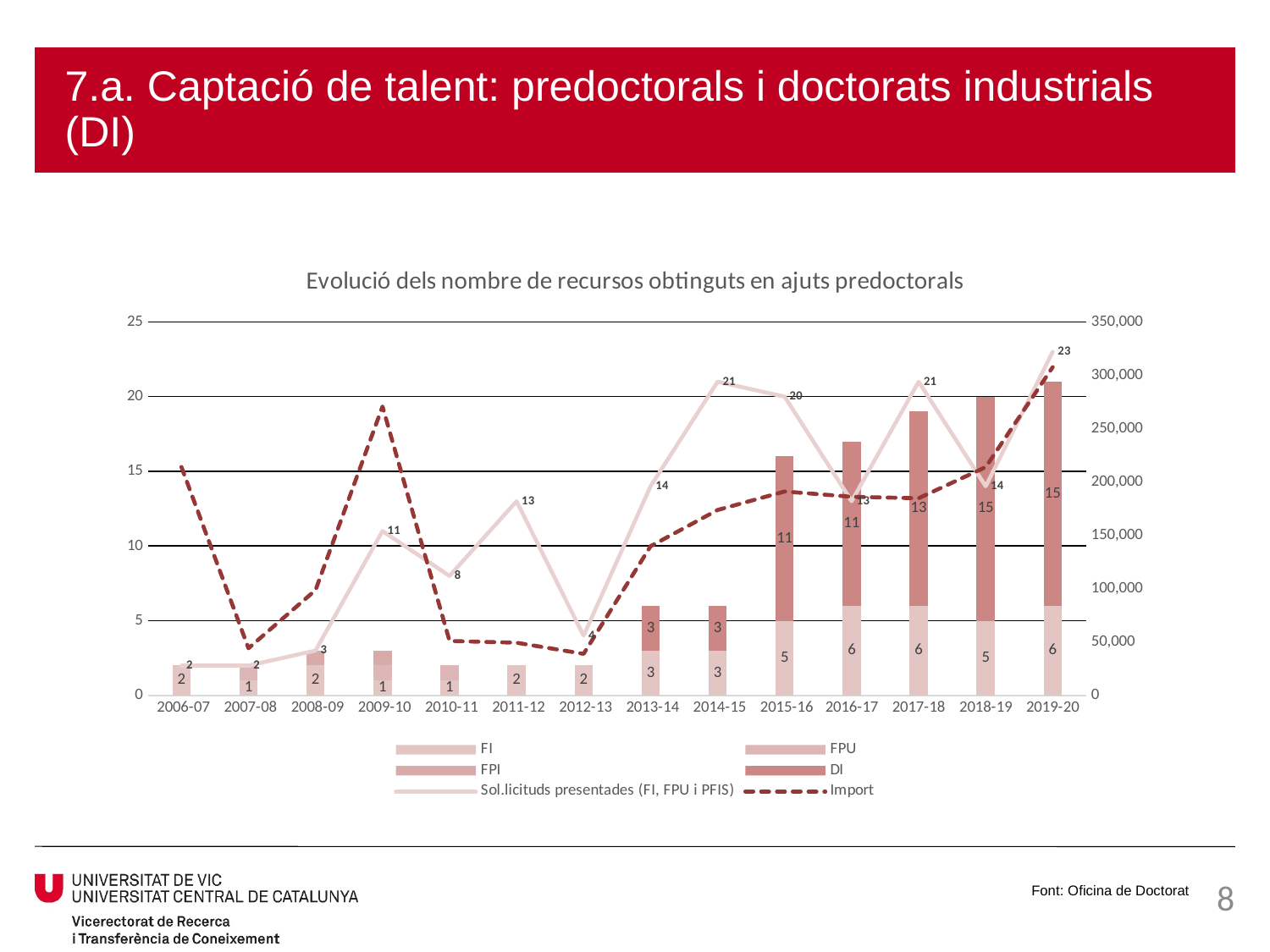
In which year is 'Sol.licituds presentades (FI, FPU i PFIS)' highest? 2019-20 What is the value of 'Sol.licituds presentades (FI, FPU i PFIS)' for 2011-12? 13 What is the value of the top (DI) segment of the 2018-19 bar? 15 How many academic years are shown on the x axis? 14 What is the title of the chart? Evolució dels nombre de recursos obtinguts en ajuts predoctorals Is the 'Import' value for 2009-10 greater or less than 250,000? greater How many series does the legend list? 6 What is the value of 'Sol.licituds presentades (FI, FPU i PFIS)' for 2019-20? 23 What is the difference in 'Sol.licituds presentades' between 2014-15 and 2013-14? 7 What is the total of the stacked bar for 2019-20? 21 Which year has more 'Sol.licituds presentades', 2009-10 or 2010-11? 2009-10 What kind of chart is used to show the FI, FPU, FPI and DI series? Stacked bar chart